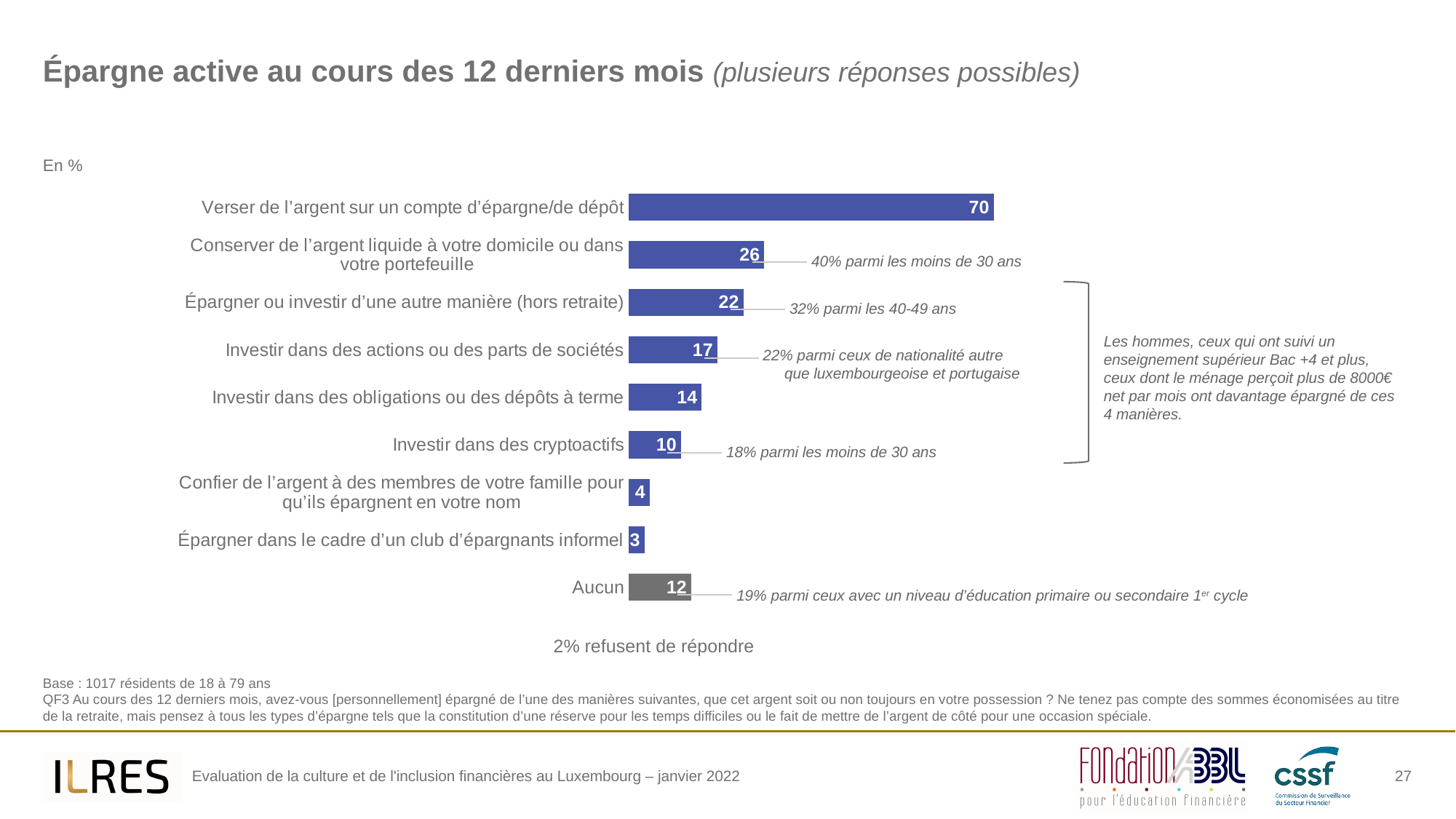
What kind of chart is shown on the slide? Bar chart Which category has the highest value? Verser de l'argent sur un compte d'épargne/de dépôt What is the difference between the values for "Conserver de l'argent liquide à votre domicile ou dans votre portefeuille" and "Épargner ou investir d'une autre manière (hors retraite)"? 4 What is the unit indicated for the chart values? En % Which category has the lowest value? Épargner dans le cadre d'un club d'épargnants informel What is the value for "Confier de l'argent à des membres de votre famille pour qu'ils épargnent en votre nom"? 4 What percentage of respondents refused to answer, according to the slide? 2% What is the value for "Aucun"? 12 What is the value for "Investir dans des cryptoactifs"? 10 Which is larger: the value for "Investir dans des actions ou des parts de sociétés" or for "Investir dans des obligations ou des dépôts à terme"? Investir dans des actions ou des parts de sociétés What is the value for "Verser de l'argent sur un compte d'épargne/de dépôt"? 70 How many categories are plotted in the chart? 9